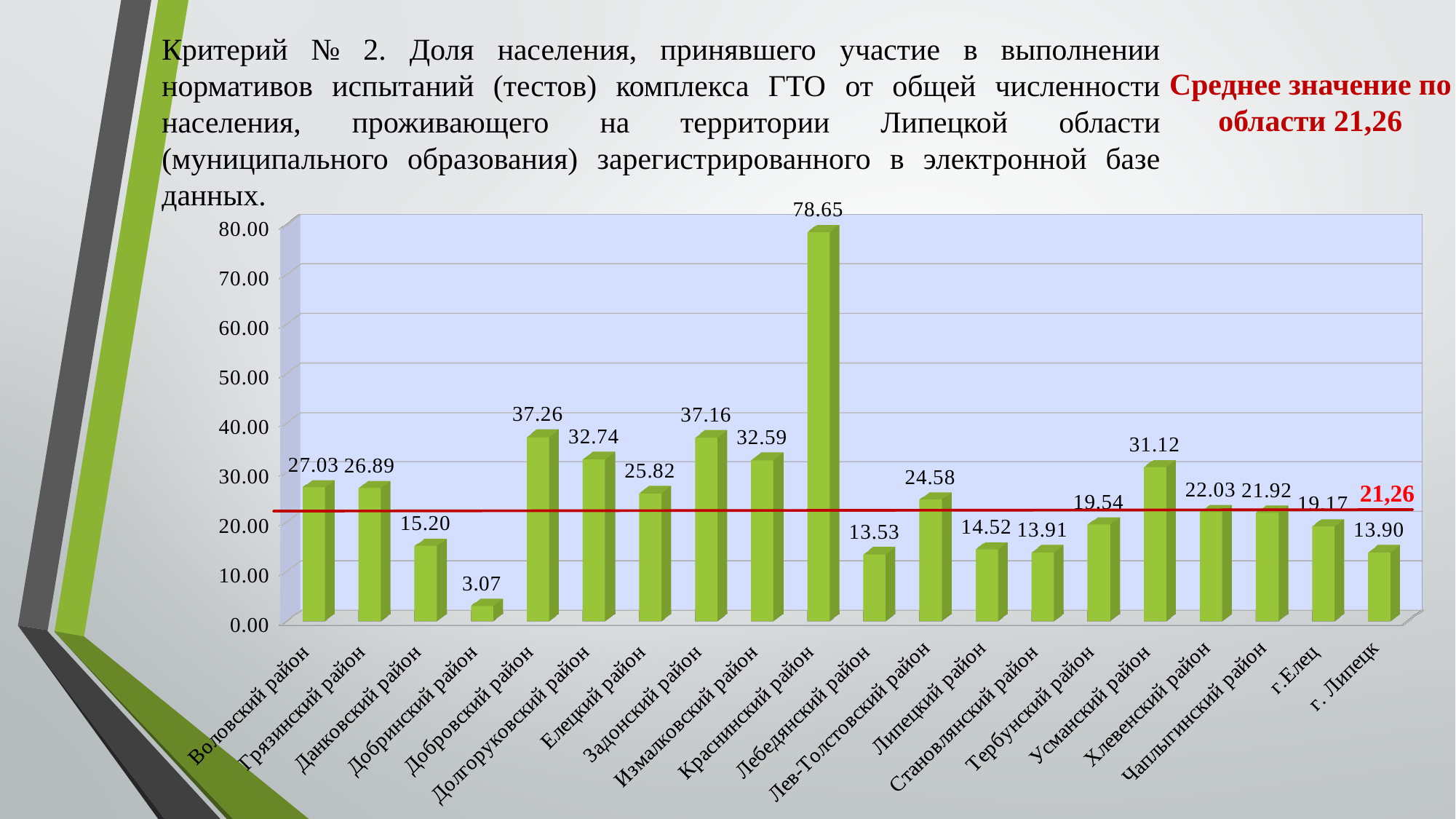
What is the difference between the values for Добровский район and Долгоруковский район? 4.52 How many categories are shown on the x axis? 20 Which is larger, the value for Задонский район or the value for Измалковский район? Задонский район What value does the red horizontal line across the chart mark? 21,26 What value is shown for Добринский район? 3.07 Which category has the lowest value? Добринский район What value is shown for г. Липецк? 13.90 What value is shown for Краснинский район? 78.65 What kind of chart is shown on the slide? bar chart Is the value for Тербунский район greater or less than 20.00? less What value is shown for Усманский район? 31.12 Which category has the highest value? Краснинский район